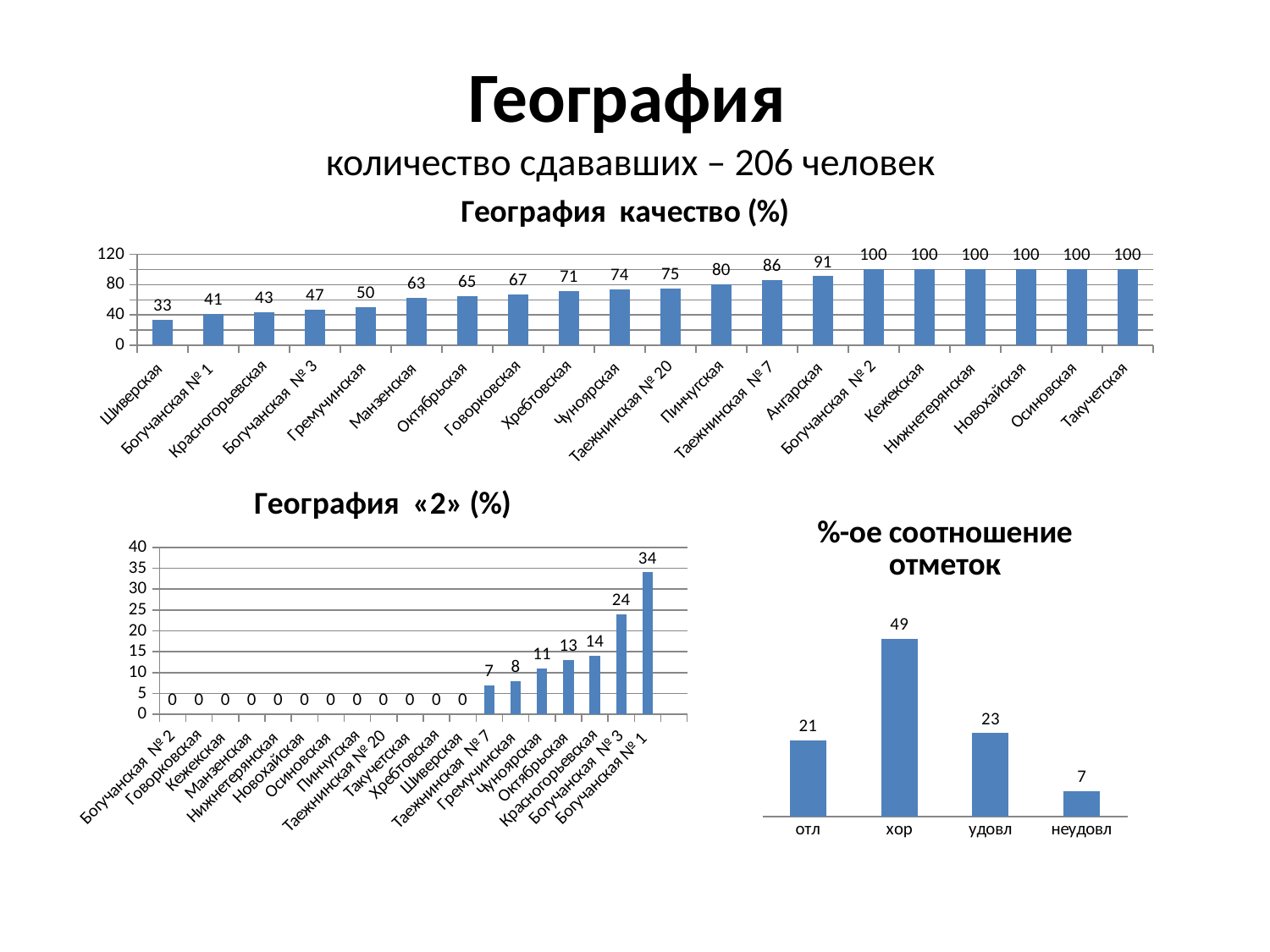
In the chart titled "География качество (%)", which is larger, the value for Манзенская or the value for Хребтовская? Хребтовская In the chart titled "%-ое соотношение отметок", which category has the lowest value? неудовл What kind of chart is the one titled "%-ое соотношение отметок"? bar chart In the chart titled "География качество (%)", what is the value for Ангарская? 91 In the chart titled "%-ое соотношение отметок", what is the value for хор? 49 In the chart titled "%-ое соотношение отметок", how many categories are shown? 4 In the chart titled "География качество (%)", which category has the lowest value? Шиверская In the chart titled "География «2» (%)", what is the difference between the values for Богучанская № 3 and Таежнинская № 7? 17 In the chart titled "География качество (%)", what is the value for Шиверская? 33 In the chart titled "География «2» (%)", which category has the highest value? Богучанская № 1 In the chart titled "География качество (%)", what is the difference between the values for Пинчугская and Гремучинская? 30 In the chart titled "География «2» (%)", what is the value for Богучанская № 1? 34